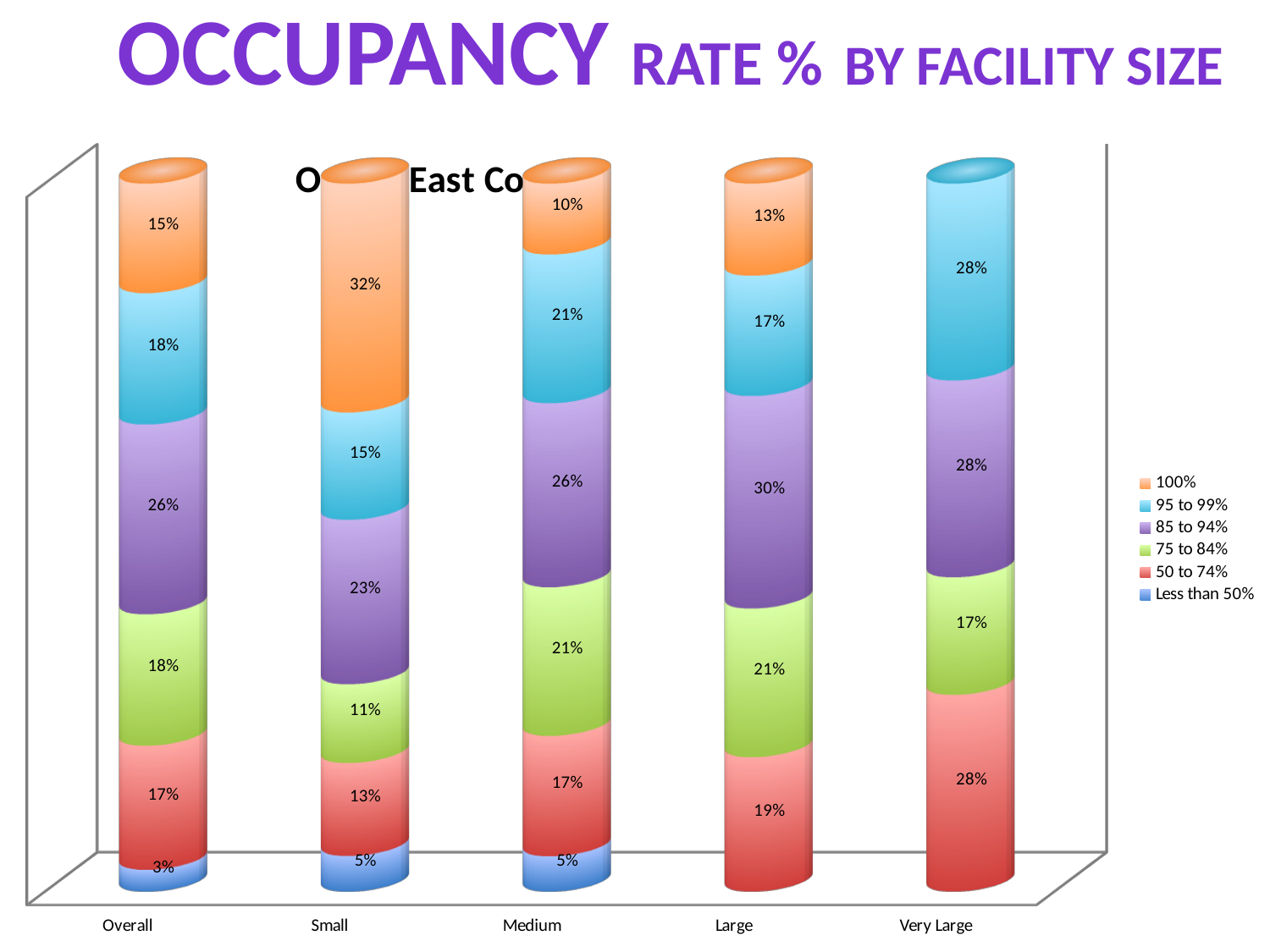
Which is larger, the 75 to 84% value for Medium or for Small? Medium What is the value of the Less than 50% segment for Overall? 3% What kind of chart is shown on the slide? Stacked bar chart Which facility size has the highest value for the 100% series? Small What is the difference between the 85 to 94% values for Large and Small? 7% What is the value of the 85 to 94% segment for Large? 30% What is the value of the 100% segment for Small? 32% How many facility size categories are shown on the x axis? 5 What is the value of the 50 to 74% segment for Very Large? 28% Which facility size has the lowest value for the 100% series among those with a labelled 100% segment? Medium How many series does the legend list? 6 What is the title of the slide's chart? Occupancy Rate % by Facility Size